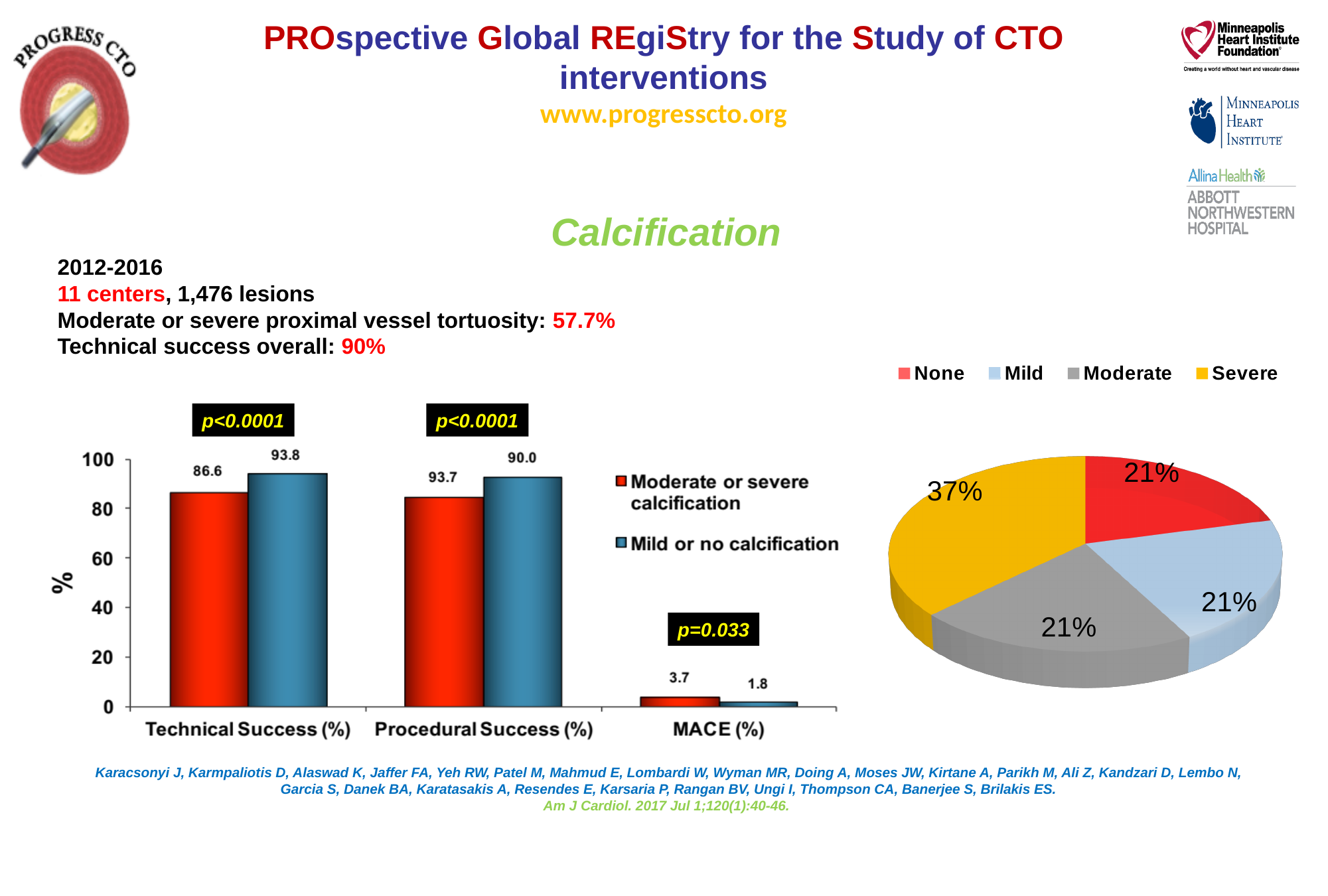
In the pie chart on the right, how many categories does the legend list? 4 What kind of chart is the chart on the left of the slide? Bar chart In the bar chart on the left, how many series does the legend list? 2 In the bar chart on the left, what is the procedural success rate for lesions with mild or no calcification? 90.0 In the bar chart on the left, which group has the higher MACE rate, moderate or severe calcification or mild or no calcification? Moderate or severe calcification In the pie chart on the right, what share of lesions had severe calcification? 37% In the pie chart on the right, which calcification category has the largest share? Severe In the bar chart on the left, how many outcome categories are shown on the x axis? 3 In the bar chart on the left, what is the technical success rate for lesions with moderate or severe calcification? 86.6 In the bar chart on the left, what is the MACE rate for lesions with moderate or severe calcification? 3.7 In the bar chart on the left, what is the difference in technical success between mild or no calcification and moderate or severe calcification? 7.2 In the pie chart on the right, what colour represents the Moderate category? Grey